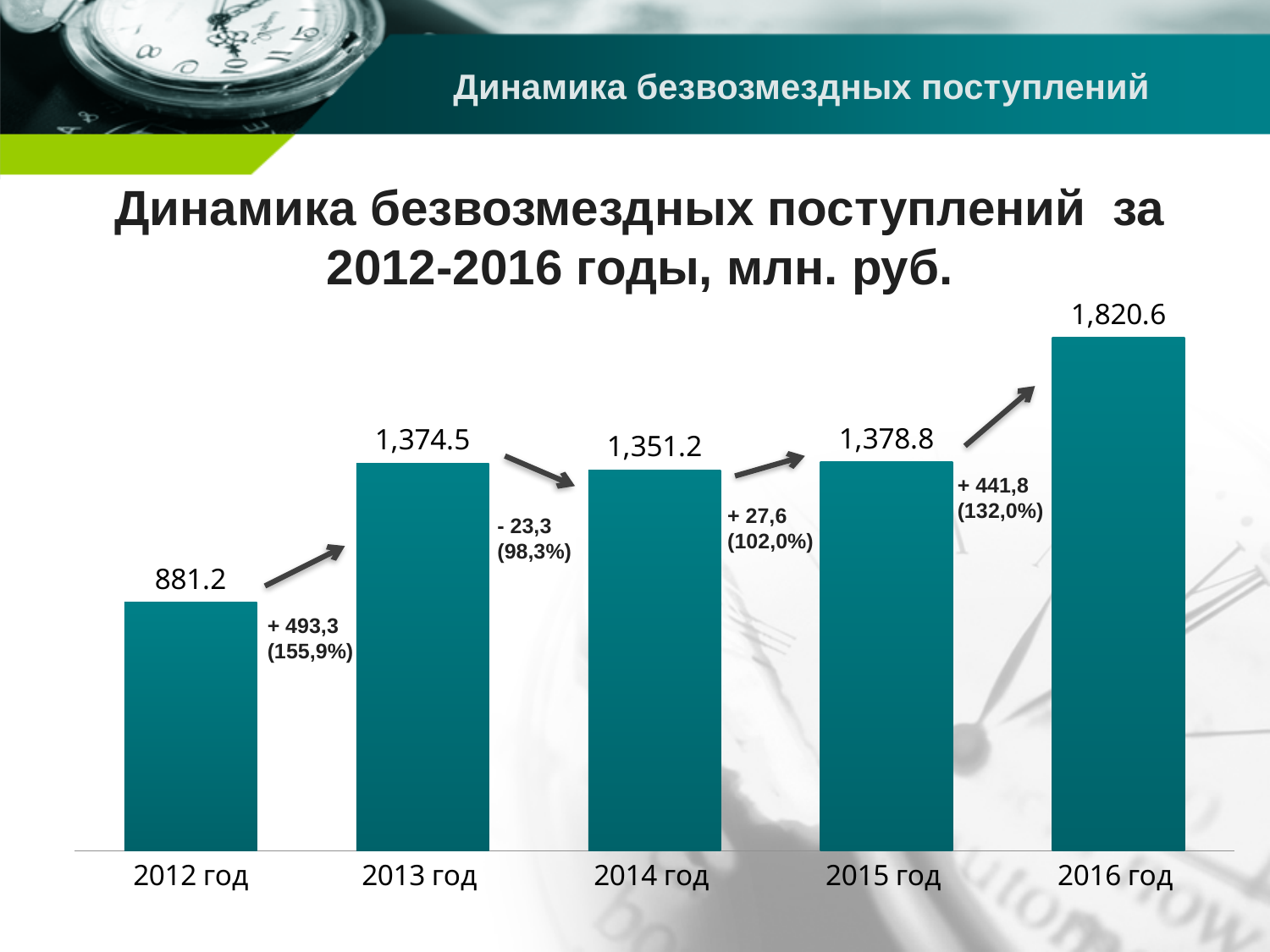
Which is larger, the value for 2013 год or the value for 2014 год? 2013 год What is the value for 2014 год? 1,351.2 What percentage is shown in the annotation between 2015 год and 2016 год? 132,0% What is the difference between the values for 2016 год and 2015 год? 441.8 What is the value for 2012 год? 881.2 What is the difference between the values for 2013 год and 2012 год? 493.3 What kind of chart is shown on the slide? bar chart Which year has the lowest value? 2012 год How many years are shown on the chart? 5 What is the value for 2016 год? 1,820.6 Does the value fall or rise from 2013 год to 2014 год? fall Which year has the highest value? 2016 год